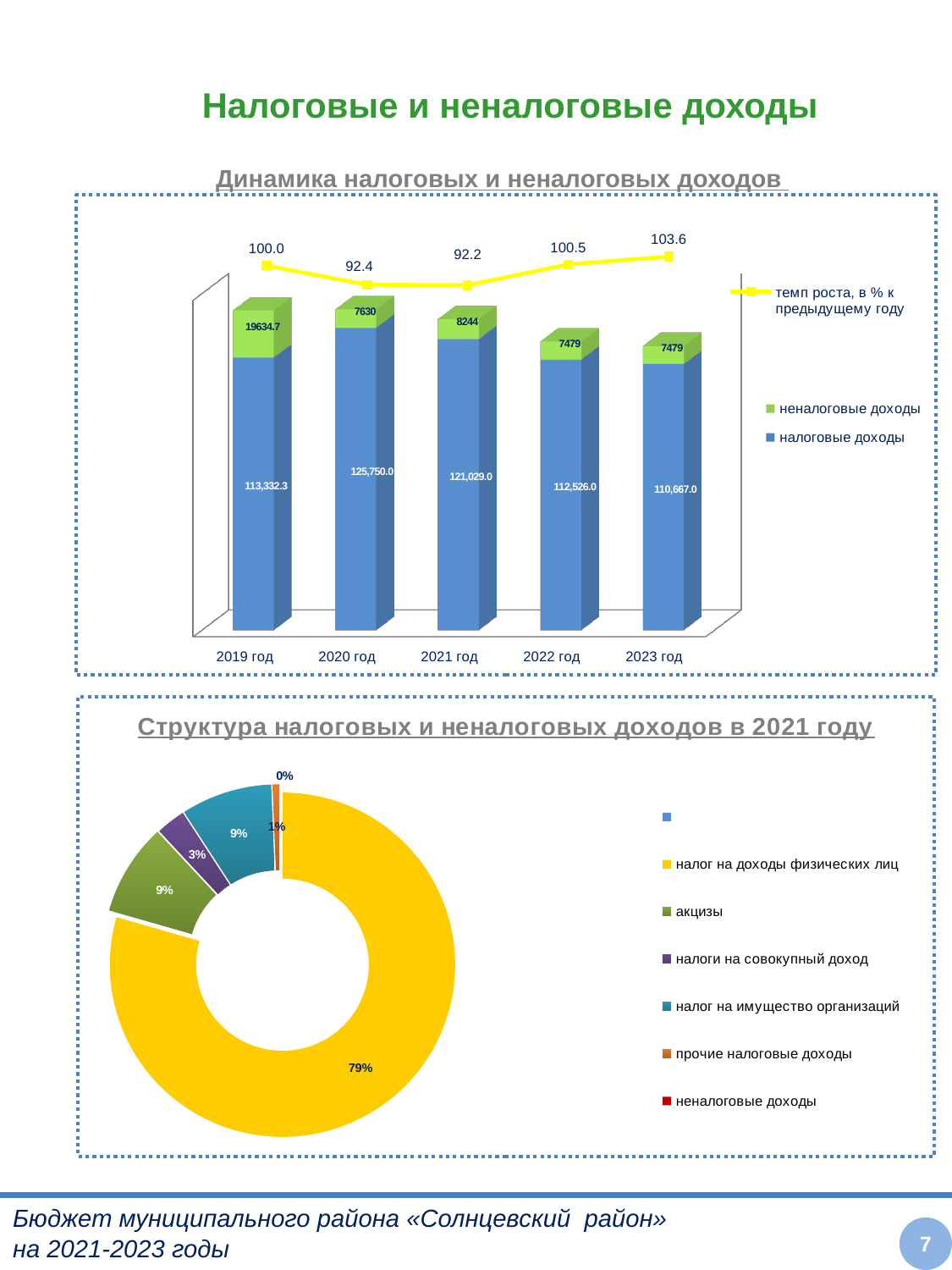
In the chart 'Динамика налоговых и неналоговых доходов', what is the value of неналоговые доходы for 2019 год? 19634.7 In the chart 'Динамика налоговых и неналоговых доходов', which year has the highest налоговые доходы? 2020 год In the chart 'Динамика налоговых и неналоговых доходов', which year has the lowest темп роста value? 2021 год In the chart 'Динамика налоговых и неналоговых доходов', how many years are shown on the x axis? 5 In the chart 'Структура налоговых и неналоговых доходов в 2021 году', what share does налог на доходы физических лиц have? 79% In the chart 'Динамика налоговых и неналоговых доходов', do the налоговые доходы values rise or fall from 2020 год to 2023 год? fall In the chart 'Динамика налоговых и неналоговых доходов', how many entries does the legend list? 3 In the chart 'Структура налоговых и неналоговых доходов в 2021 году', what share does налоги на совокупный доход have? 3% In the chart 'Динамика налоговых и неналоговых доходов', what is the value of налоговые доходы for 2020 год? 125,750.0 In the chart 'Динамика налоговых и неналоговых доходов', what is the difference between налоговые доходы in 2020 год and 2021 год? 4,721.0 In the chart 'Динамика налоговых и неналоговых доходов', what is the темп роста value for 2023 год? 103.6 What kind of chart is 'Структура налоговых и неналоговых доходов в 2021 году'? doughnut (pie) chart